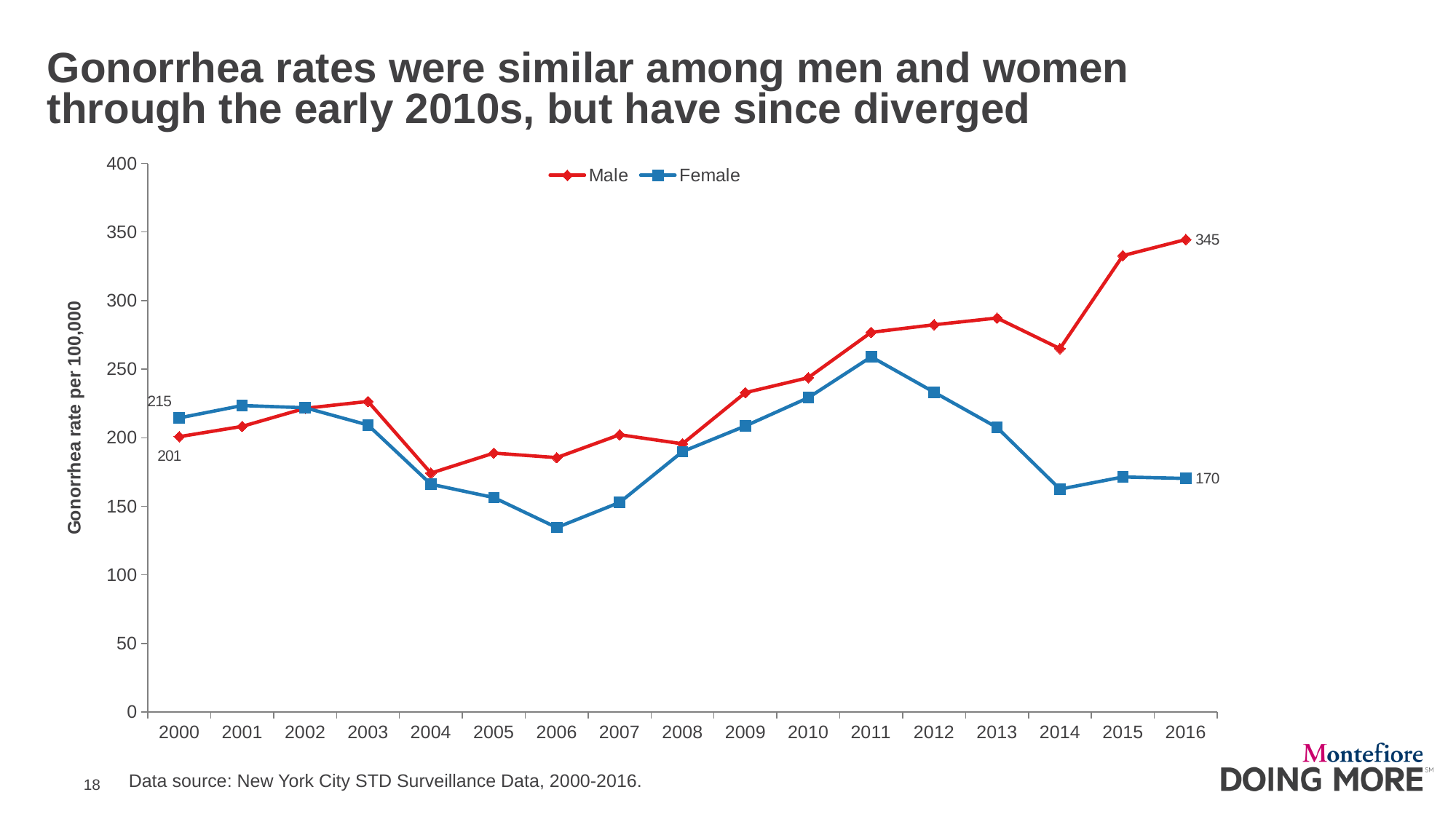
What is the difference between the male and female gonorrhea rates in 2016? 175 In which year was the female gonorrhea rate at its lowest? 2006 What was the gonorrhea rate per 100,000 for females in 2000? 215 What was the gonorrhea rate per 100,000 for males in 2000? 201 What was the gonorrhea rate per 100,000 for females in 2016? 170 What kind of chart is shown on the slide? Line chart Is the male gonorrhea rate in 2015 greater or less than 300? greater How many series does the legend list? 2 What was the gonorrhea rate per 100,000 for males in 2016? 345 In 2000, which group had the higher gonorrhea rate, males or females? Female Is the female gonorrhea rate in 2006 greater or less than 150? less By how much did the male gonorrhea rate increase from 2000 to 2016? 144